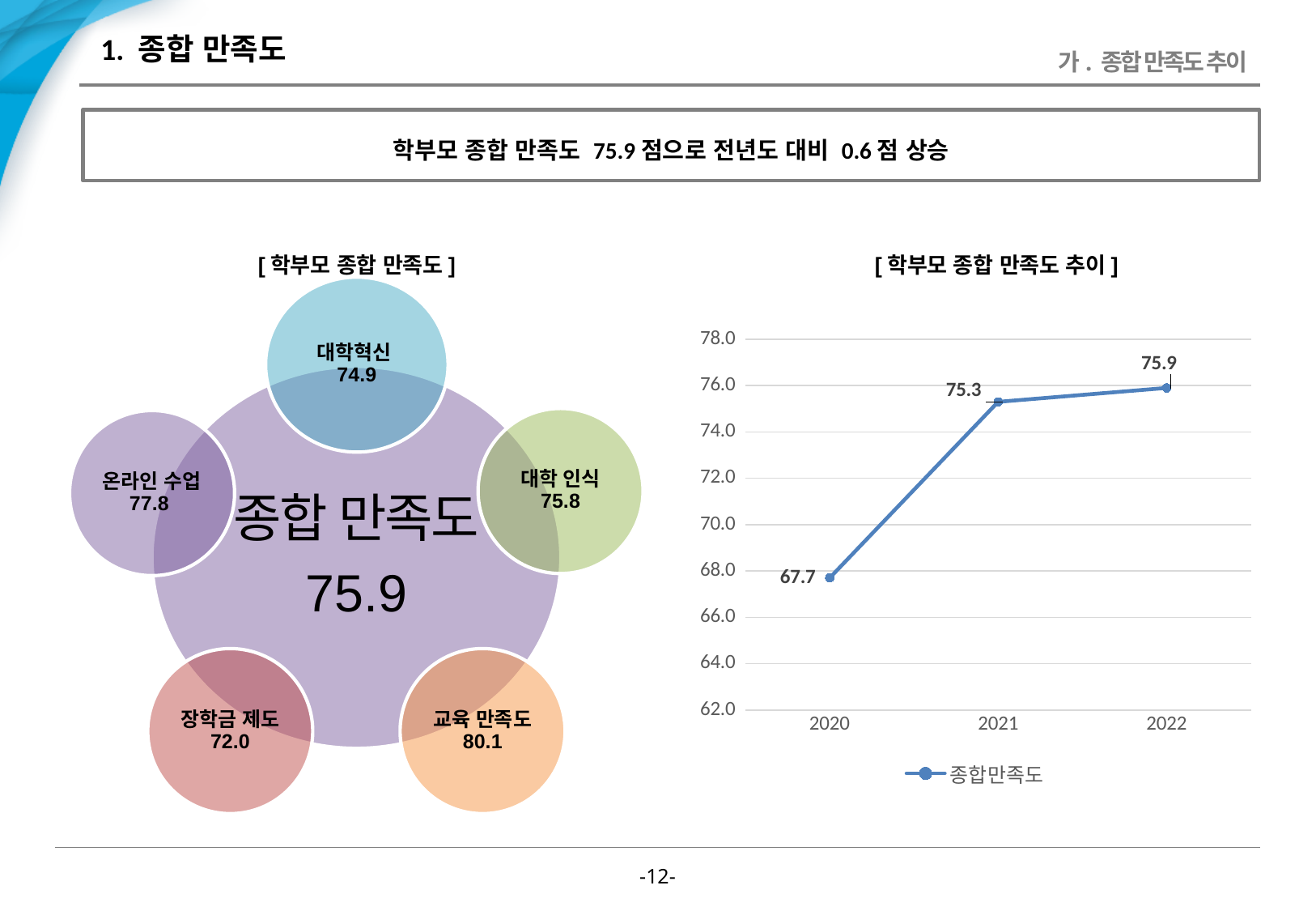
In the line chart titled [ 학부모 종합 만족도 추이 ], what is the difference between the 2021 and 2020 values? 7.6 In the line chart titled [ 학부모 종합 만족도 추이 ], what is the name of the series shown in the legend? 종합만족도 What type of chart is the one titled [ 학부모 종합 만족도 추이 ]? line chart In the line chart titled [ 학부모 종합 만족도 추이 ], what is the difference between the 2022 and 2021 values? 0.6 In the line chart titled [ 학부모 종합 만족도 추이 ], which year has the highest value? 2022 In the line chart titled [ 학부모 종합 만족도 추이 ], what is the value for 2021? 75.3 In the line chart titled [ 학부모 종합 만족도 추이 ], what is the value for 2022? 75.9 In the line chart titled [ 학부모 종합 만족도 추이 ], how many data points are plotted? 3 In the line chart titled [ 학부모 종합 만족도 추이 ], do the values rise or fall from 2020 to 2022? rise In the line chart titled [ 학부모 종합 만족도 추이 ], what is the value for 2020? 67.7 In the line chart titled [ 학부모 종합 만족도 추이 ], which year has the lowest value? 2020 In the diagram titled [ 학부모 종합 만족도 ] on the left, what is the value shown for 교육 만족도? 80.1